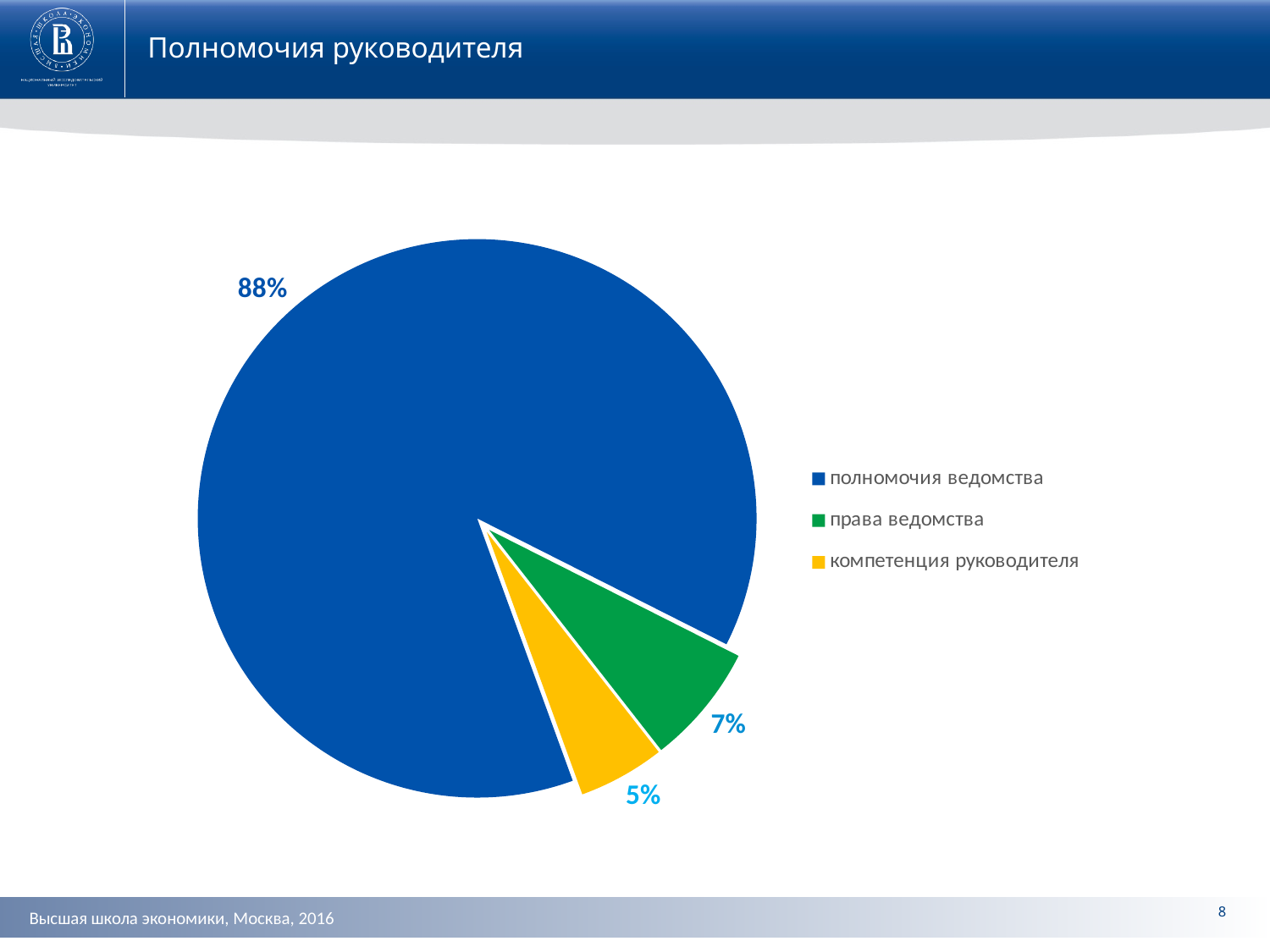
What is the difference between the shares of "права ведомства" and "компетенция руководителя"? 2% Which category has the smallest slice of the pie? компетенция руководителя What share of the pie does "полномочия ведомства" have? 88% What colour is the slice for "компетенция руководителя"? yellow How many entries does the legend list? 3 What kind of chart is shown on the slide? pie chart What is the difference between the shares of "полномочия ведомства" and "права ведомства"? 81% Which category has the largest slice of the pie? полномочия ведомства Which is larger, the share of "права ведомства" or the share of "компетенция руководителя"? права ведомства What share of the pie does "права ведомства" have? 7% What share of the pie does "компетенция руководителя" have? 5% How many slices does the pie chart have? 3